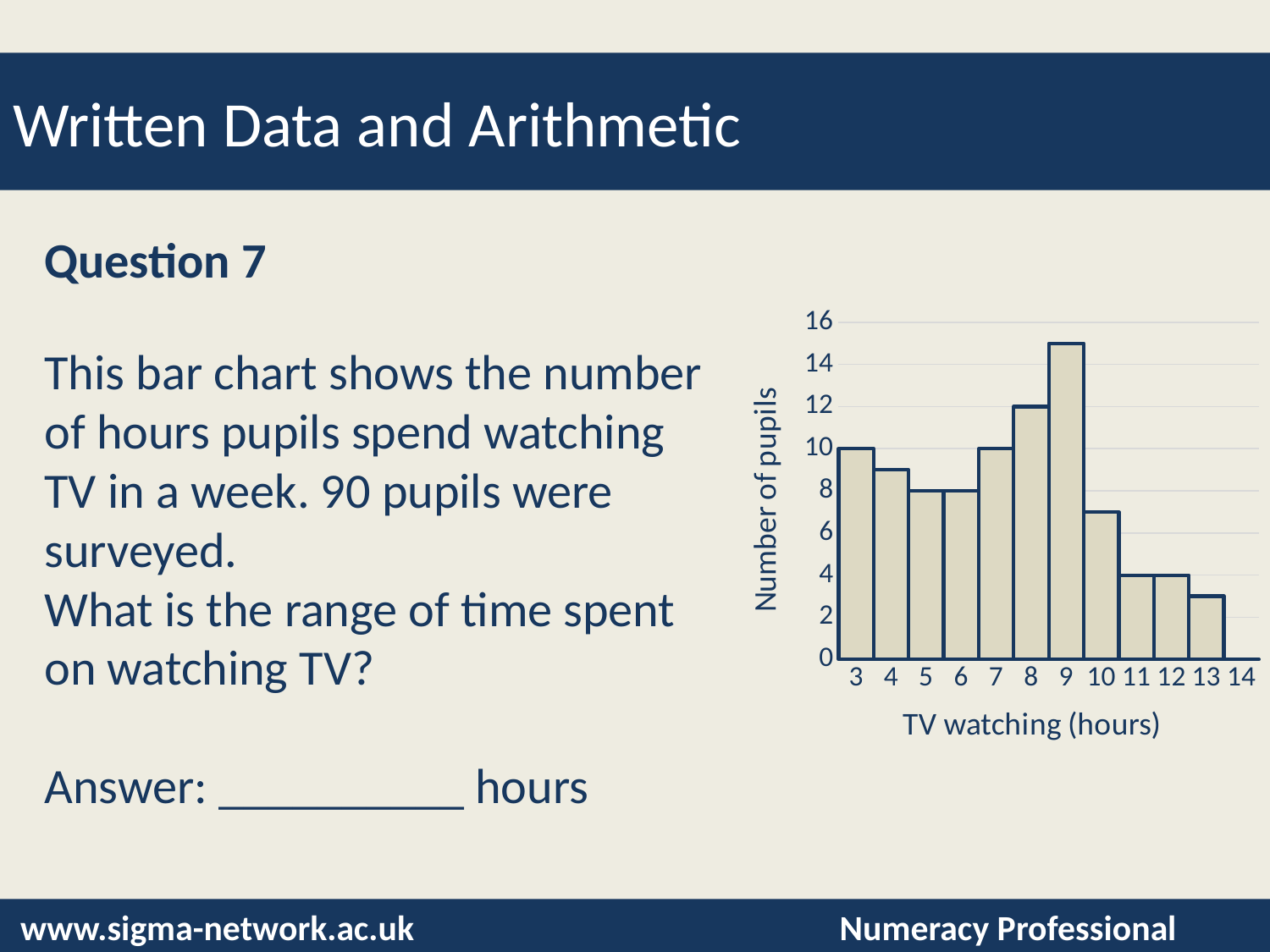
How many pupils watch TV for 11 hours a week? 4 How many bars are plotted in the chart? 11 How many pupils watch TV for 8 hours a week? 12 What is the label of the x axis of the chart? TV watching (hours) What kind of chart is shown on the slide? bar chart What is the difference between the number of pupils watching 8 hours and the number watching 3 hours of TV? 2 Is the number of pupils watching 10 hours of TV greater or less than 8? less Which has more pupils: 7 hours or 5 hours of TV watching? 7 hours How many pupils watch TV for 3 hours a week? 10 Is the number of pupils watching 9 hours of TV greater or less than 14? greater Which number of TV watching hours has the highest number of pupils? 9